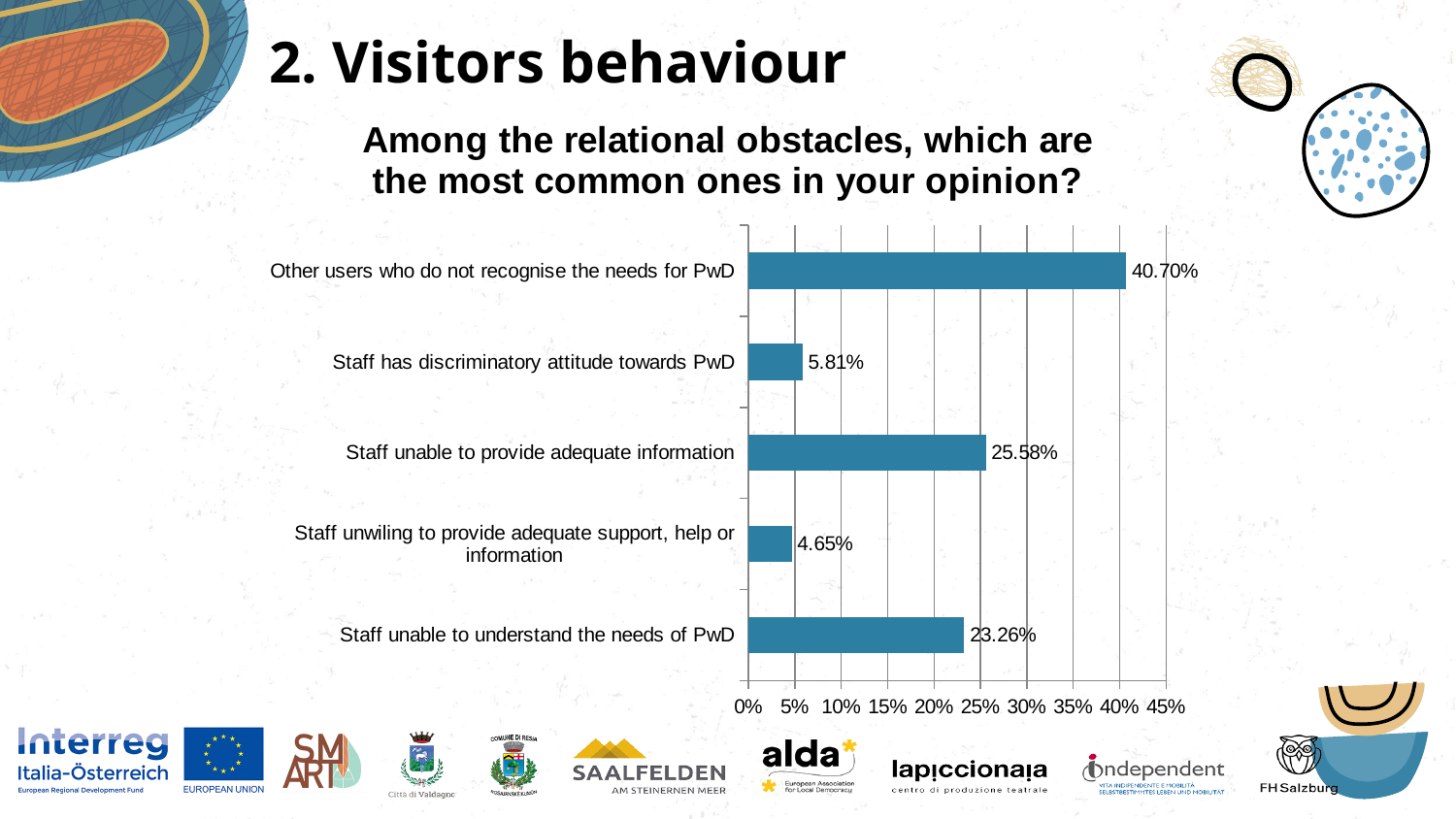
Which category has the lowest value? Staff unwiling to provide adequate support, help or information How many categories are shown in the chart? 5 What is the value for "Staff unable to understand the needs of PwD"? 23.26% What is the value for "Staff has discriminatory attitude towards PwD"? 5.81% What is the value for "Staff unwiling to provide adequate support, help or information"? 4.65% What kind of chart is shown on the slide? Bar chart What is the value for "Other users who do not recognise the needs for PwD"? 40.70% Which category has the highest value? Other users who do not recognise the needs for PwD What is the difference between the values for "Other users who do not recognise the needs for PwD" and "Staff unable to provide adequate information"? 15.12% Which is larger: the value for "Staff unable to provide adequate information" or "Staff unable to understand the needs of PwD"? Staff unable to provide adequate information What is the title of the chart? Among the relational obstacles, which are the most common ones in your opinion? What is the value for "Staff unable to provide adequate information"? 25.58%